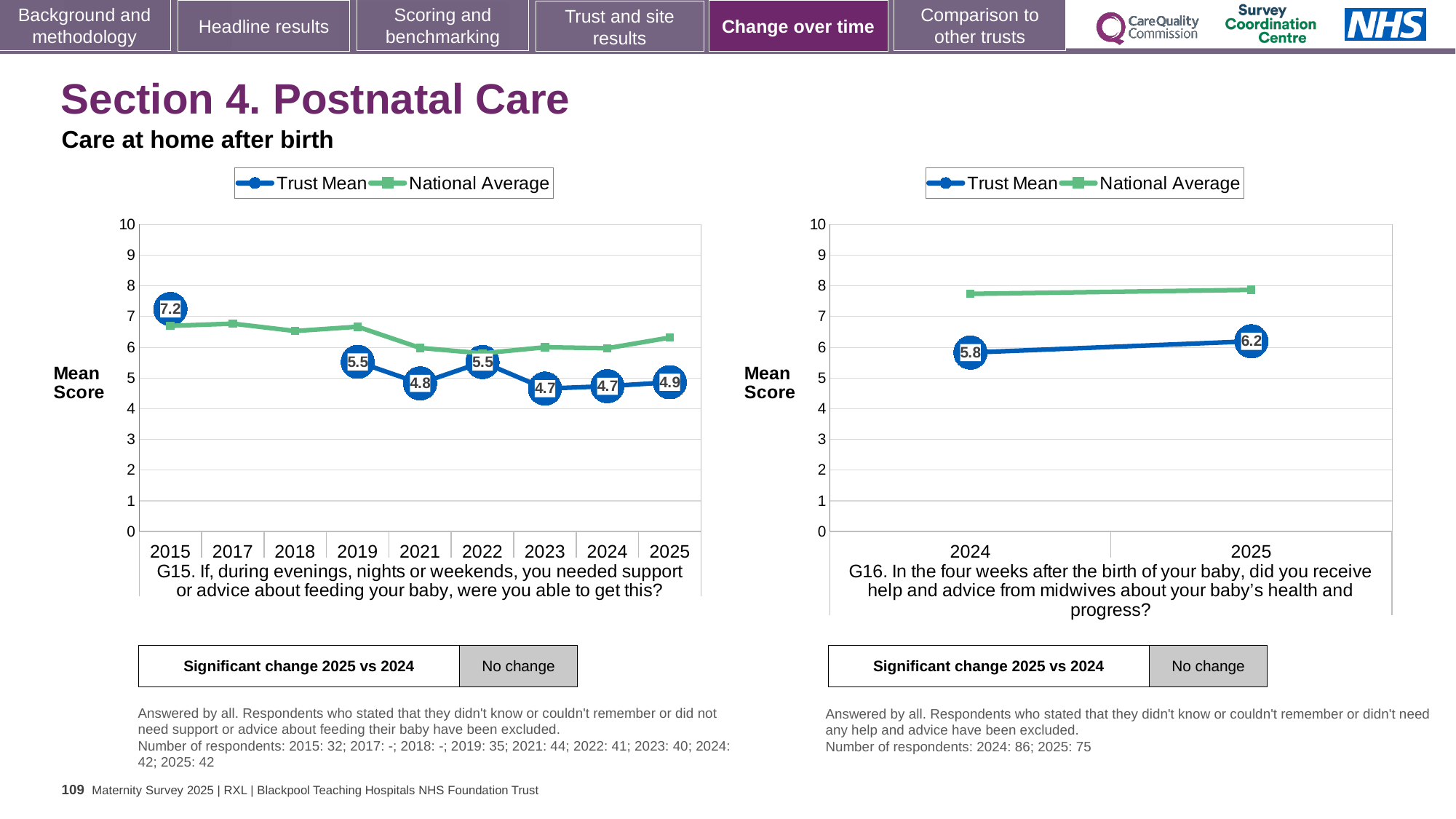
In the G16 chart on the right, is the National Average for 2025 greater or less than 7? greater In the G15 chart on the left, what is the difference between the Trust Mean for 2015 and 2025? 2.3 In the G16 chart on the right, what is the Trust Mean for 2025? 6.2 In the G15 chart on the left, what is the Trust Mean for 2015? 7.2 In the G15 chart on the left, what is the Trust Mean for 2025? 4.9 In the G15 chart on the left, which year has the highest Trust Mean? 2015 In the G16 chart on the right, what is the difference between the Trust Mean for 2025 and 2024? 0.4 What kind of chart is the G16 chart on the right? Line chart How many years are shown on the x axis of the G15 chart on the left? 9 In the G16 chart on the right, what is the Trust Mean for 2024? 5.8 How many series does the legend of the G16 chart on the right list? 2 In the G15 chart on the left, is the Trust Mean higher in 2022 or in 2023? 2022